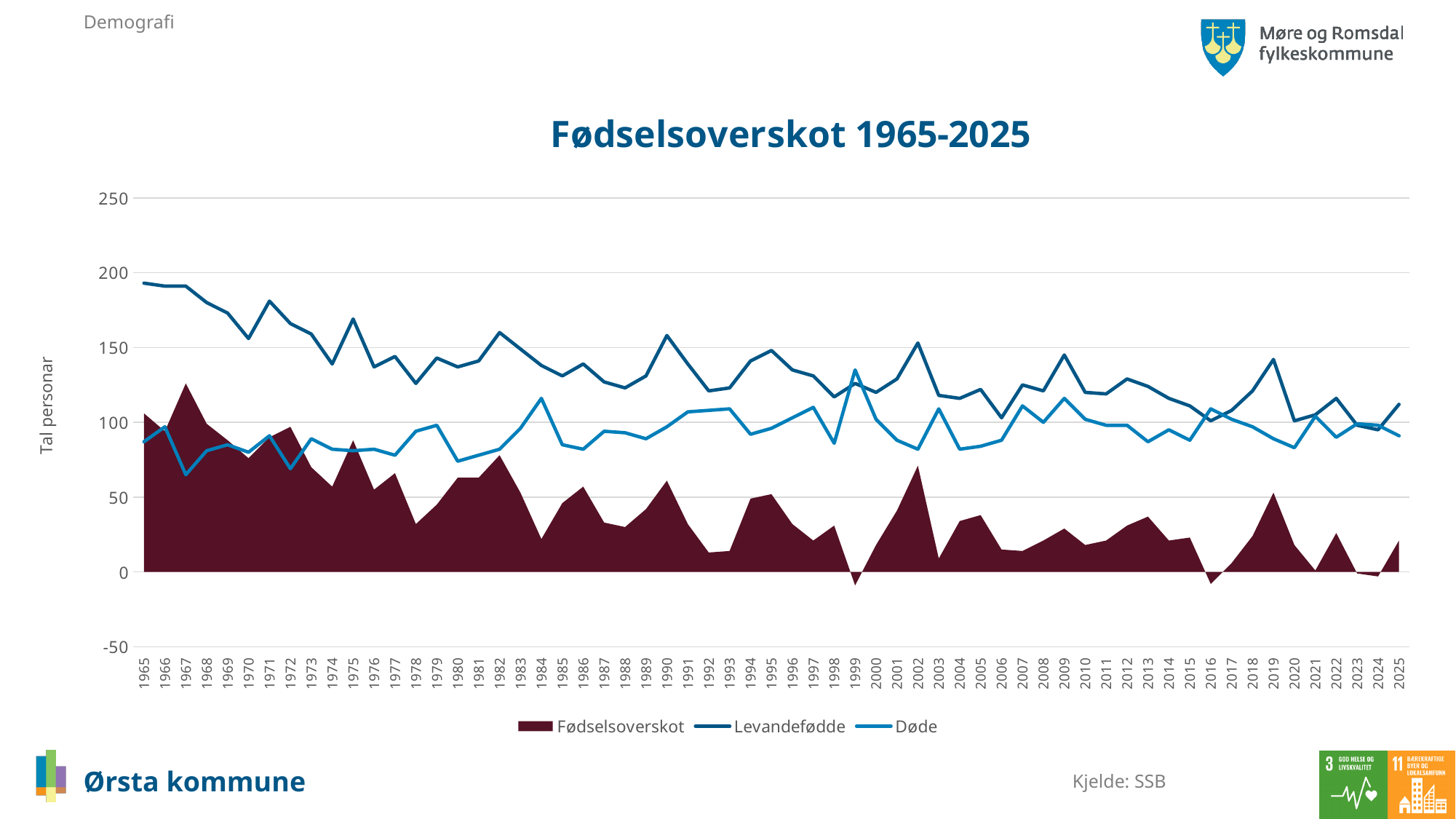
Does the Levandefødde series generally rise or fall from 1965 to 2025? fall What is the label on the vertical axis of the chart? Tal personar In 1965, which is larger: Levandefødde or Døde? Levandefødde How many years are plotted along the x axis of the chart? 61 What is the title of the chart? Fødselsoverskot 1965-2025 Is the value for Fødselsoverskot in 2016 greater or less than 0? less Is the value for Fødselsoverskot in 1967 greater or less than 100? greater Is the value for Levandefødde in 2025 greater or less than 150? less How many series does the chart legend list? 3 In which year does Fødselsoverskot reach its highest value? 1967